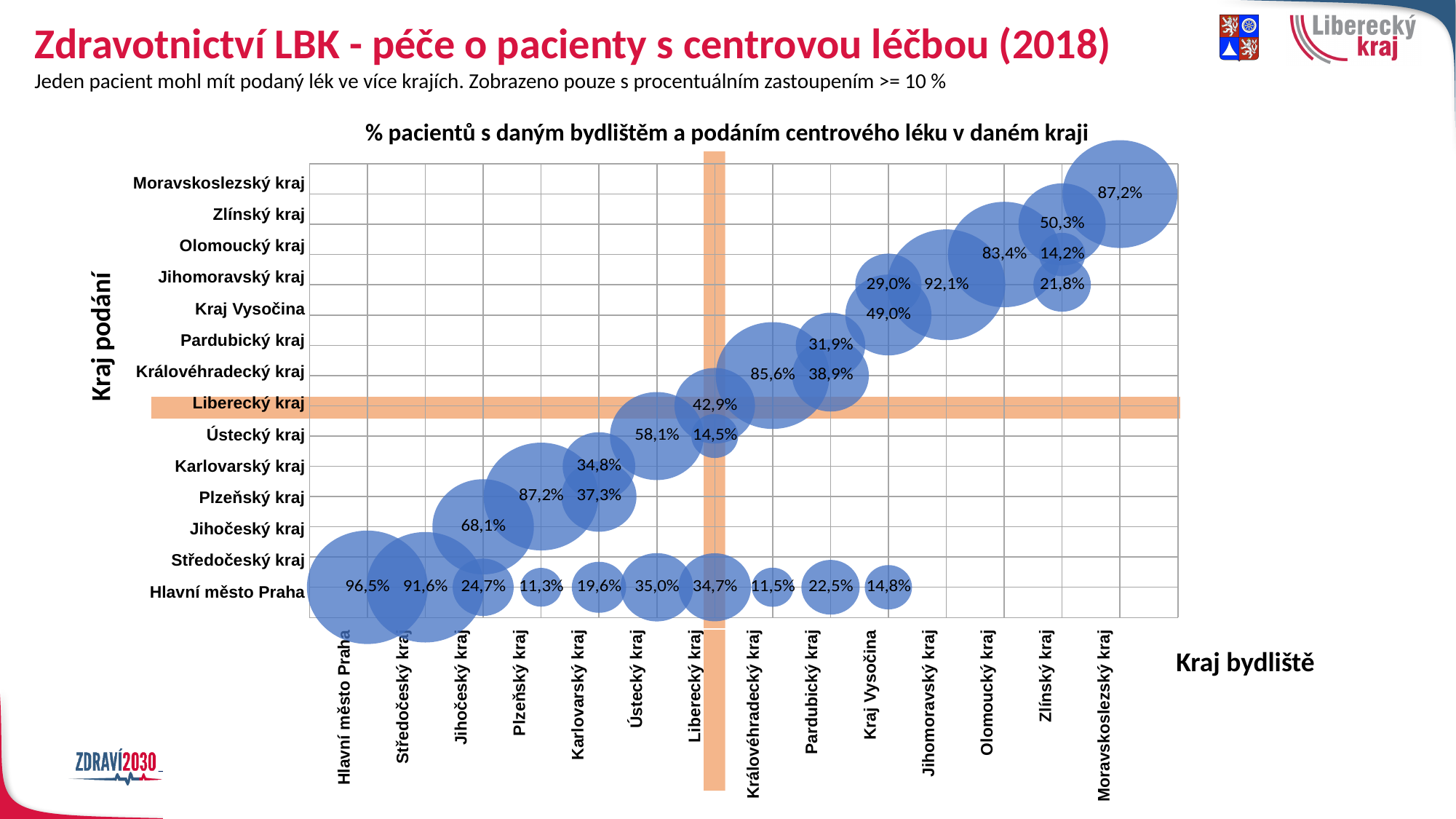
What is the title of the chart? % pacientů s daným bydlištěm a podáním centrového léku v daném kraji Which combination of region of residence and region of administration has the highest percentage shown on the chart? Hlavní město Praha / Hlavní město Praha (96,5%) What value is shown for patients residing in Liberecký kraj with medication administered in Liberecký kraj? 42,9% What type of chart is shown on the slide? Bubble chart What value is shown for patients residing in Zlínský kraj with medication administered in Olomoucký kraj? 14,2% What is the lowest percentage value labelled on the chart? 11,3% What percentage of patients residing in Jihomoravský kraj received centre-administered medication in Jihomoravský kraj? 92,1% What value is shown for patients residing in Liberecký kraj with medication administered in Hlavní město Praha? 34,7% Which is larger: the value for Ústecký kraj residents treated in Ústecký kraj, or the value for Liberecký kraj residents treated in Liberecký kraj? Ústecký kraj residents treated in Ústecký kraj (58,1%) How many regions of residence are listed along the x axis? 14 What percentage of patients residing in Hlavní město Praha received centre-administered medication in Hlavní město Praha? 96,5% What is the difference between the value for Středočeský kraj residents treated in Hlavní město Praha (91,6%) and Jihočeský kraj residents treated in Hlavní město Praha (24,7%)? 66,9 percentage points